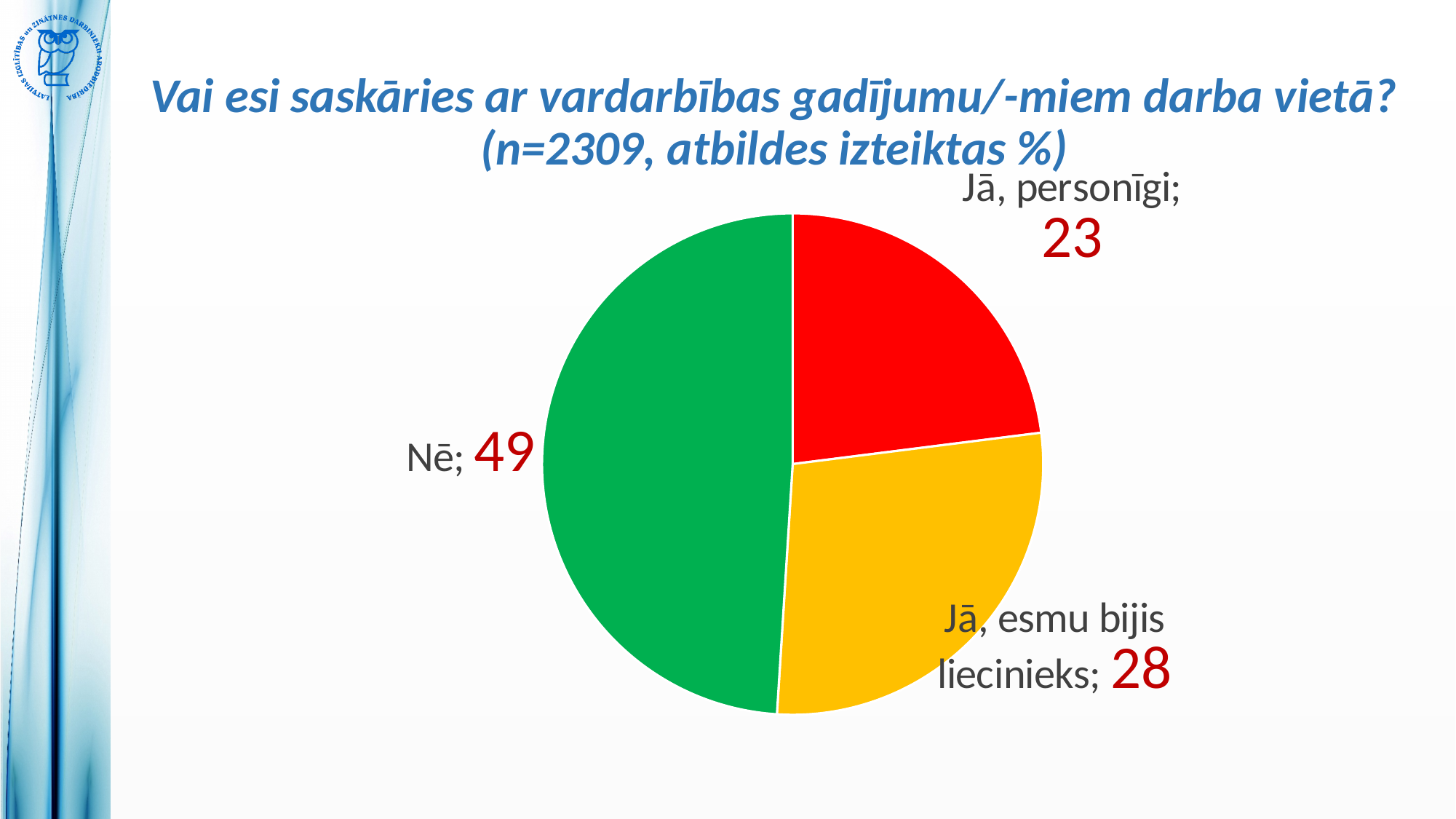
What is the value for "Jā, esmu bijis liecinieks"? 28 What is the value for "Jā, personīgi"? 23 What sample size (n) is stated in the chart title? 2309 Which category has the smallest slice? Jā, personīgi What kind of chart is shown on the slide? pie chart What is the difference between the values for "Jā, esmu bijis liecinieks" and "Jā, personīgi"? 5 What is the difference between the values for "Nē" and "Jā, personīgi"? 26 What is the value for "Nē"? 49 How many slices does the pie chart have? 3 Which is larger, the value for "Jā, esmu bijis liecinieks" or the value for "Jā, personīgi"? Jā, esmu bijis liecinieks Which category has the largest slice? Nē What colour is the "Nē" slice? green